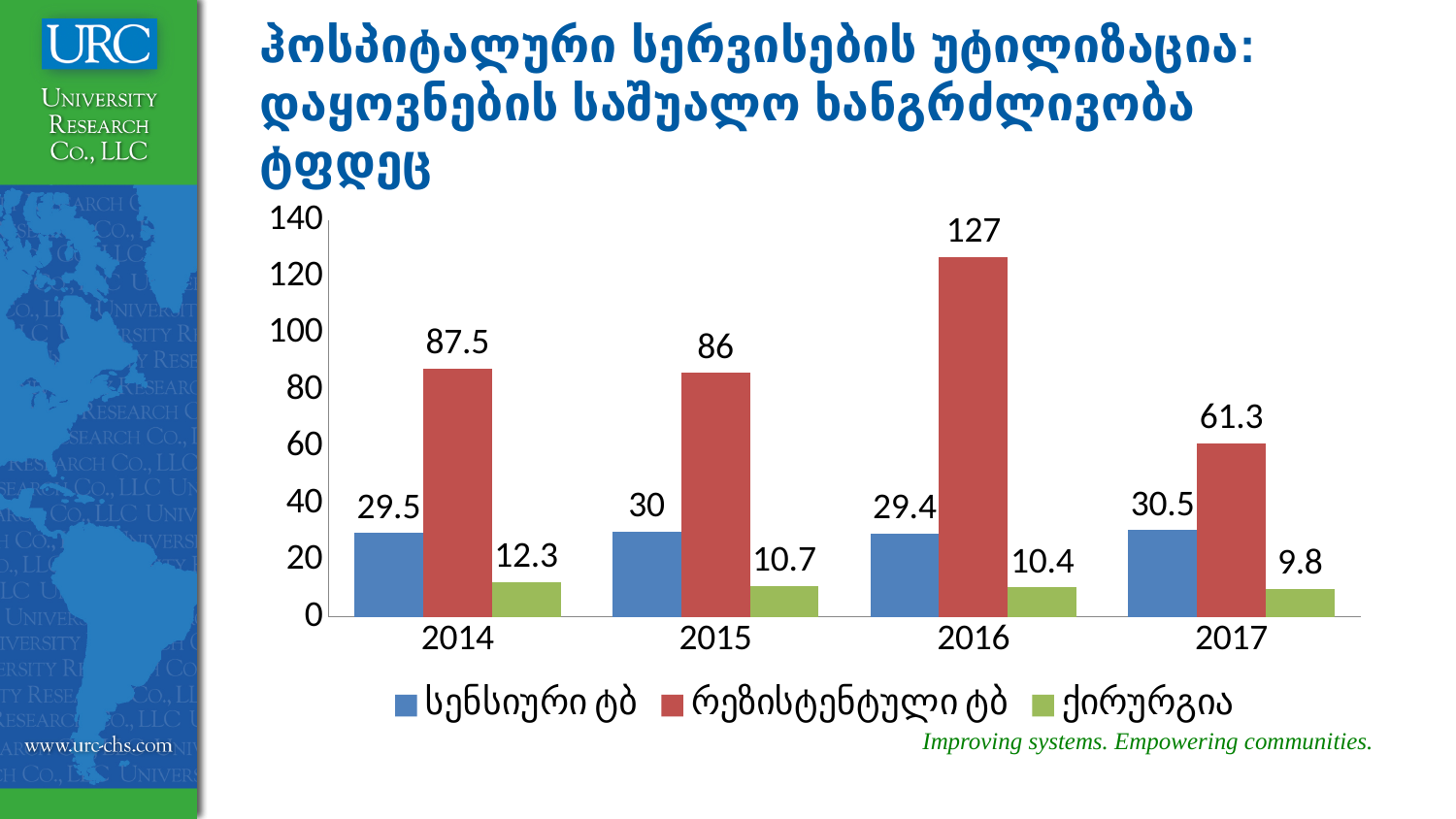
Does the value for ქირურგია rise or fall from 2014 to 2017? fall Which is larger: the სენსიური ტბ value in 2015 or in 2016? 2015 How many series does the legend list? 3 What is the difference between the რეზისტენტული ტბ values in 2016 and 2017? 65.7 What is the value for ქირურგია in 2014? 12.3 What is the value for სენსიური ტბ in 2017? 30.5 Is the value for რეზისტენტული ტბ in 2017 greater or less than 80? less In which year is the value for ქირურგია lowest? 2017 What kind of chart is shown on the slide? bar chart What is the value for რეზისტენტული ტბ in 2016? 127 In which year is the value for რეზისტენტული ტბ highest? 2016 How many years are shown on the x axis? 4